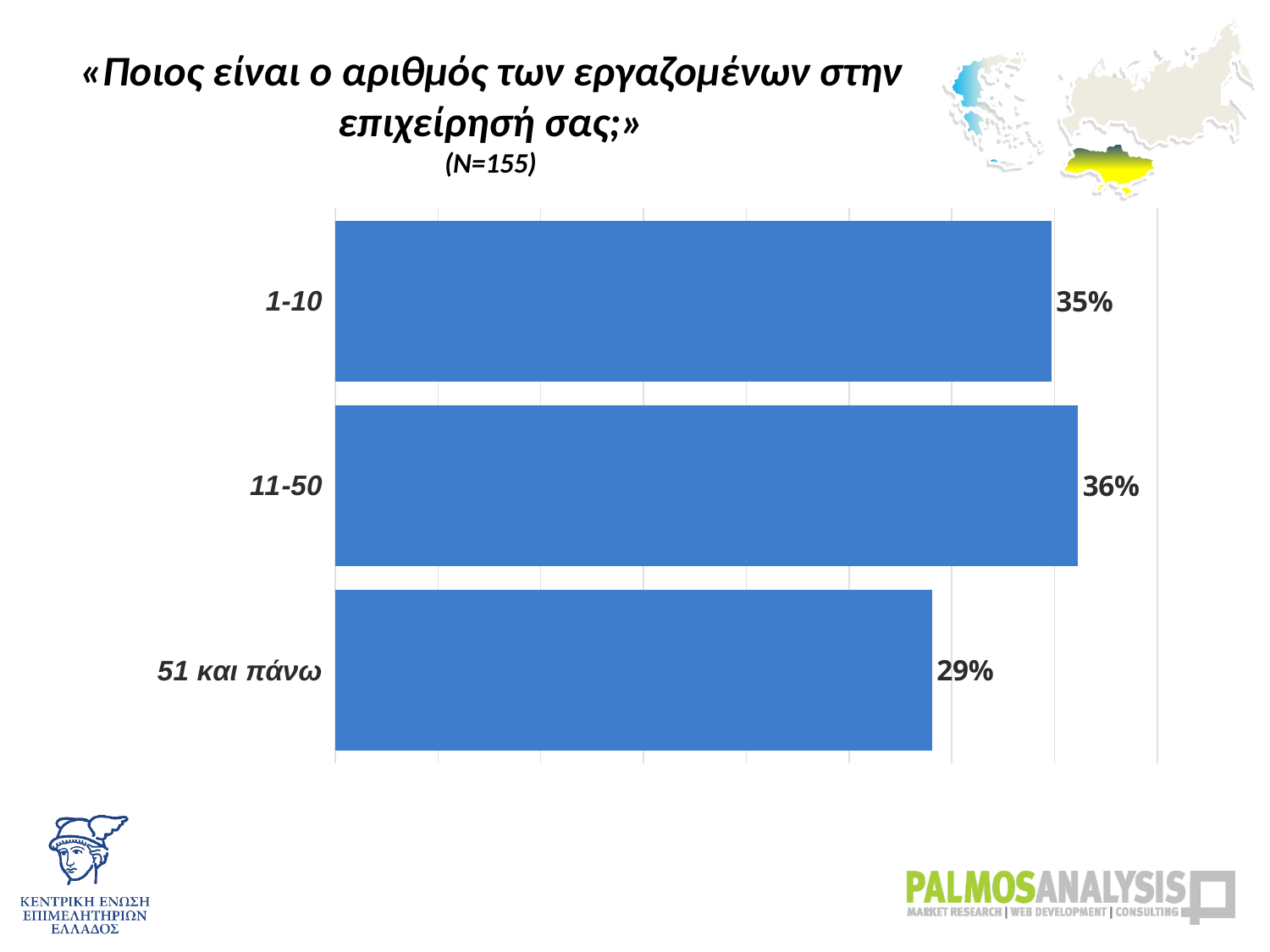
Which category has the highest value? 11-50 What is the difference between the values for 1-10 and '51 και πάνω'? 6% What kind of chart is shown on the slide? Bar chart What is the difference between the values for 11-50 and '51 και πάνω'? 7% What colour are the bars in the chart? Blue Which category has the lowest value? 51 και πάνω What is the value for the 1-10 category? 35% Which is larger, the value for 1-10 or the value for '51 και πάνω'? 1-10 What is the value for the '51 και πάνω' category? 29% What is the sample size (N) stated under the chart title? N=155 What is the value for the 11-50 category? 36% How many categories are shown in the chart? 3